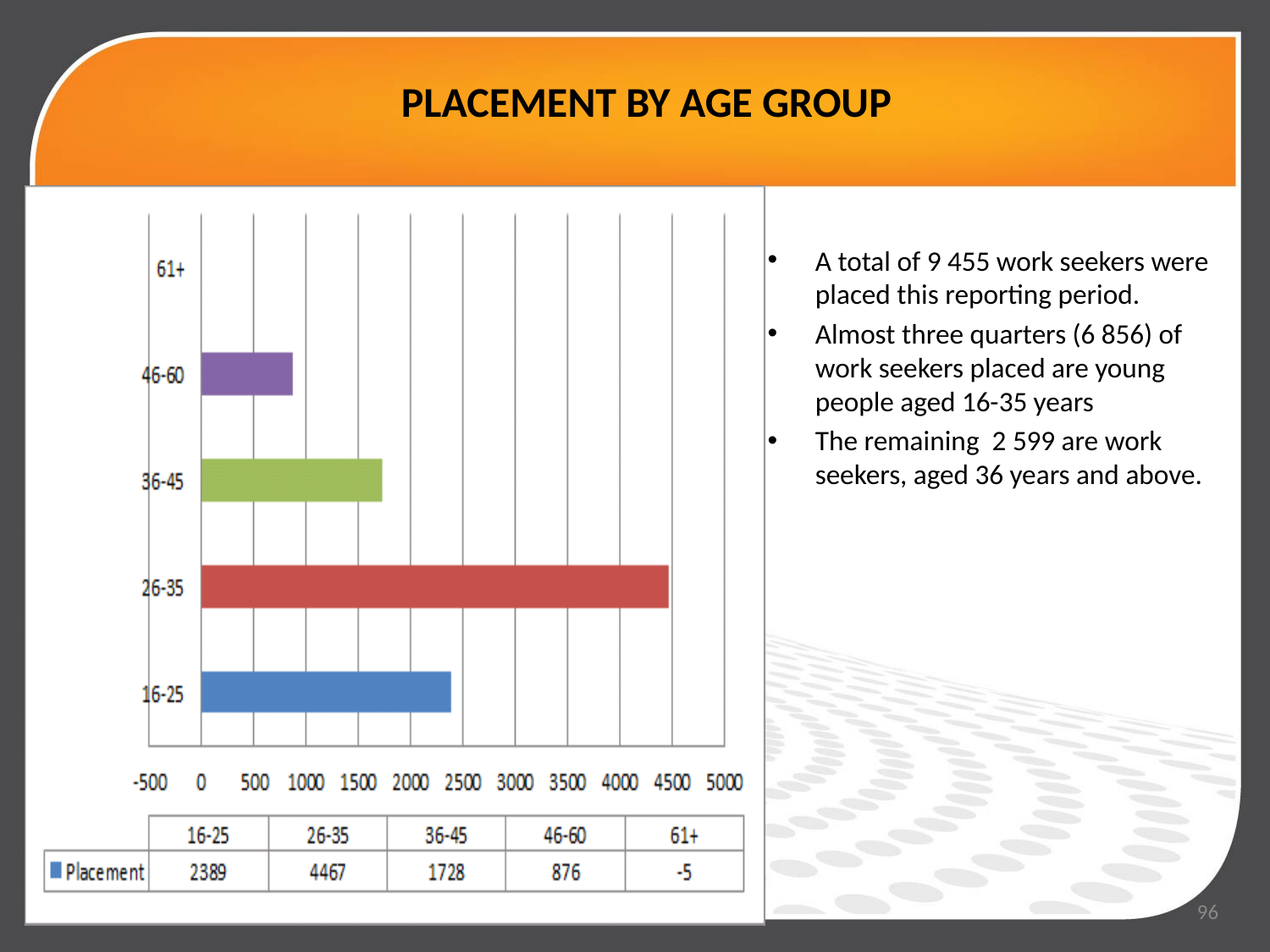
What is the Placement value for the 61+ age group? -5 What is the title of the slide containing the chart? PLACEMENT BY AGE GROUP What is the Placement value for the 16-25 age group? 2389 What is the difference between the Placement values for the 26-35 and 16-25 age groups? 2078 Which age group has a larger Placement value, 36-45 or 46-60? 36-45 Which age group has the highest Placement value? 26-35 What is the Placement value for the 46-60 age group? 876 How many series does the chart's data table list? 1 Which age group has the lowest Placement value? 61+ What type of chart is shown on the slide? Bar chart How many age groups are shown in the chart? 5 What is the Placement value for the 26-35 age group? 4467